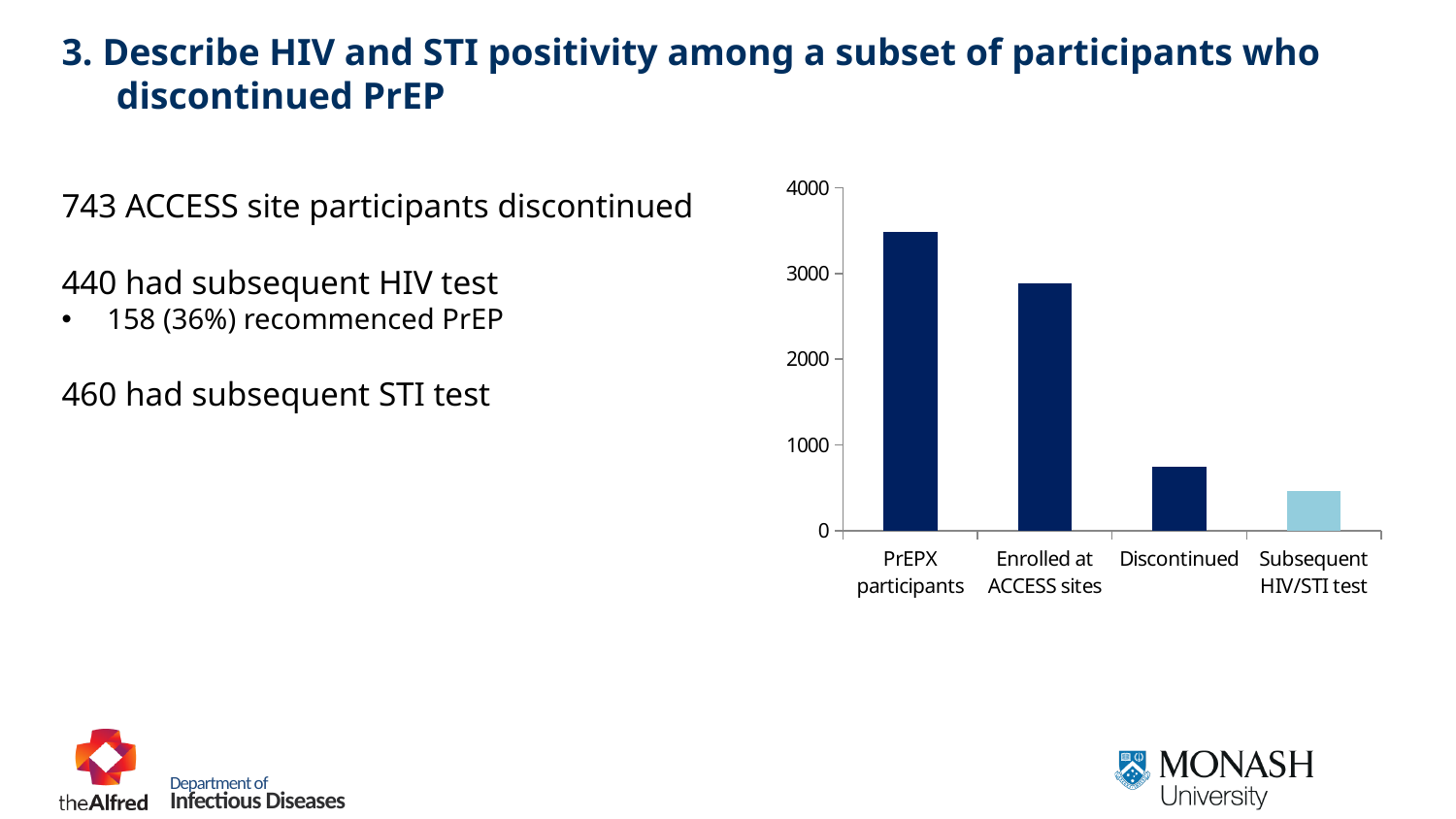
Which category has the highest bar? PrEPX participants Is the value for Enrolled at ACCESS sites greater or less than 2000? greater Which category has the lowest bar? Subsequent HIV/STI test How many categories are plotted on the chart? 4 Which is larger, the bar for PrEPX participants or the bar for Enrolled at ACCESS sites? PrEPX participants Is the value for Discontinued greater or less than 1000? less Which is larger, the bar for Discontinued or the bar for Subsequent HIV/STI test? Discontinued Is the value for Subsequent HIV/STI test greater or less than 1000? less Do the bar values rise or fall from left to right across the x axis? fall What kind of chart is shown on the slide? bar chart Which category's bar is shown in a lighter blue colour than the others? Subsequent HIV/STI test